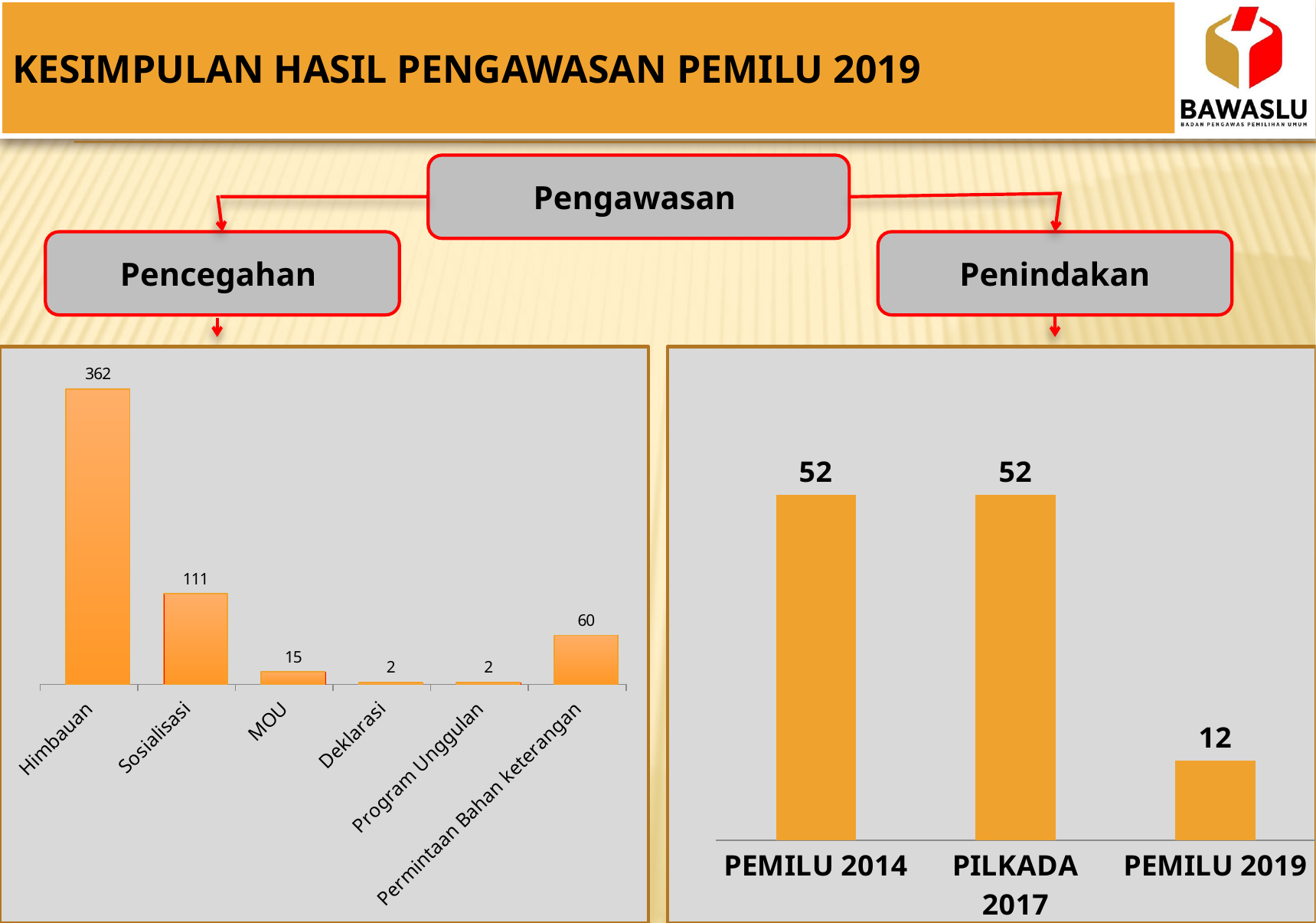
In the right chart (under Penindakan), which category has the lowest value? PEMILU 2019 What kind of chart is the right chart (under Penindakan)? Bar chart In the left chart (under Pencegahan), what is the difference between Himbauan and Sosialisasi? 251 In the right chart (under Penindakan), what is the value for PEMILU 2019? 12 In the right chart (under Penindakan), what is the value for PILKADA 2017? 52 In the left chart (under Pencegahan), what is the value for Permintaan Bahan keterangan? 60 In the left chart (under Pencegahan), which is larger, MOU or Permintaan Bahan keterangan? Permintaan Bahan keterangan In the right chart (under Penindakan), what is the difference between PEMILU 2014 and PEMILU 2019? 40 In the left chart (under Pencegahan), how many categories are shown? 6 In the left chart (under Pencegahan), which category has the highest value? Himbauan In the left chart (under Pencegahan), what is the value for Himbauan? 362 In the left chart (under Pencegahan), what is the value for Sosialisasi? 111